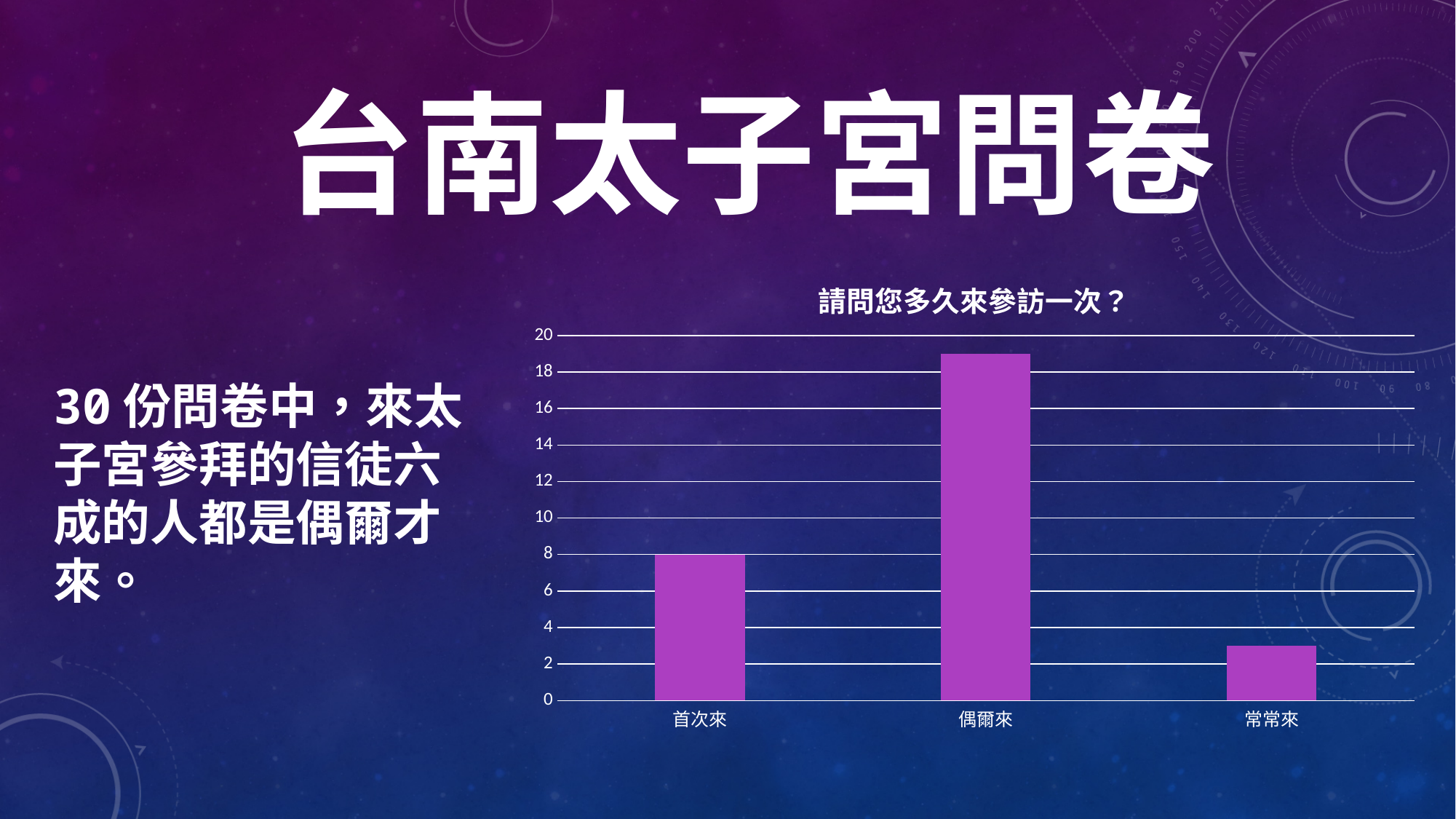
Is the value for 偶爾來 greater or less than 18? greater What is the value for 首次來? 8 Is the value for 偶爾來 greater or less than 20? less What is the title of the chart? 請問您多久來參訪一次？ What type of chart is shown on the slide? bar chart Which category has the lowest value? 常常來 What is the maximum value shown on the y axis of the chart? 20 Is the value for 常常來 greater or less than 2? greater Which is larger, the value for 首次來 or the value for 常常來? 首次來 How many categories are shown on the x axis of the chart? 3 Which category has the highest value? 偶爾來